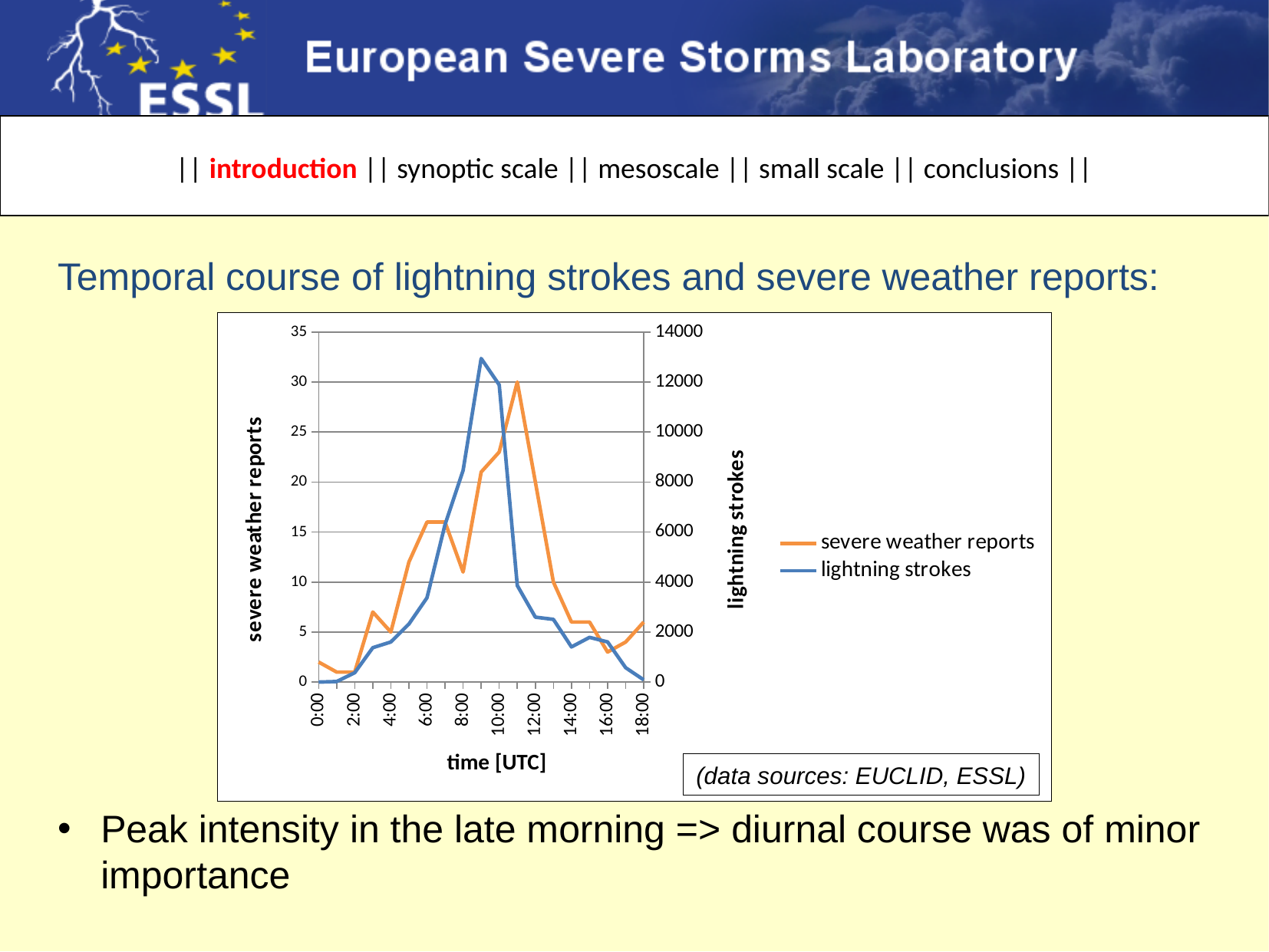
What kind of chart is shown on the slide? line chart Is the value for severe weather reports at 8:00 greater or less than 15? less What is the title of the chart's x axis? time [UTC] Which is larger: lightning strokes at 9:00 or at 11:00? 9:00 How many series does the chart's legend list? 2 At what time do severe weather reports reach their highest value? 11:00 Do lightning strokes rise or fall between 0:00 and 9:00? rise Is the value for lightning strokes at 9:00 greater or less than 12000? greater At what time do lightning strokes reach their highest value? 9:00 Is the value for severe weather reports at 11:00 greater or less than 25? greater Which is larger: severe weather reports at 6:00 or at 8:00? 6:00